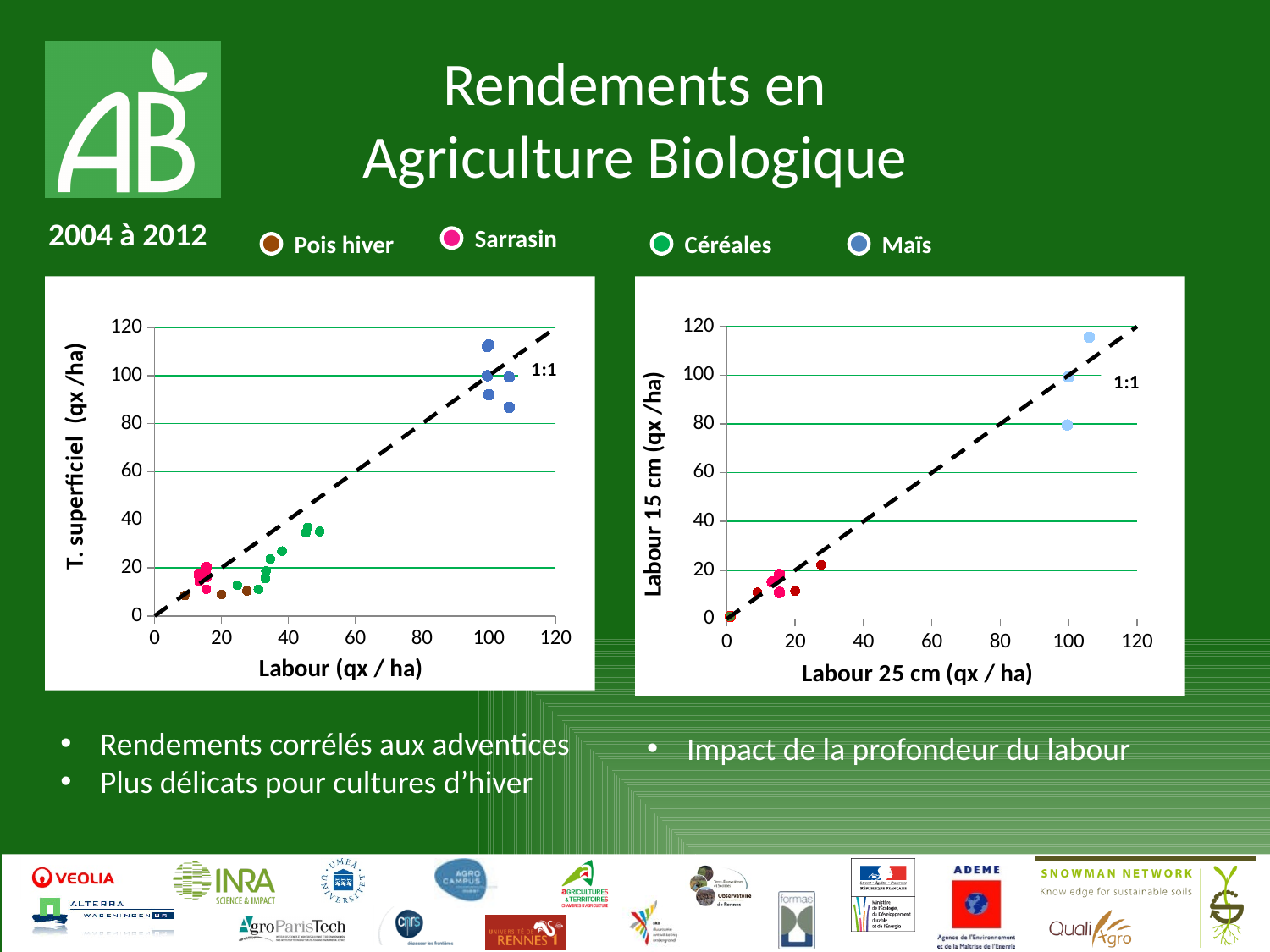
In the right chart, are the Sarrasin points on the x axis (Labour 25 cm) greater or less than 40? less How many series does the legend above the charts list? 4 In the left chart, are the Maïs points on the x axis (Labour) greater or less than 80? greater In the left chart, which series has the highest yield values? Maïs What is the maximum value shown on the x axis of the right chart? 120 In the right chart, which series has the highest yield values? Maïs In the left chart, are the Céréales points on the y axis (T. superficiel) greater or less than 60? less What is the x-axis title of the left chart? Labour (qx / ha) What kind of chart is the right chart on the slide? scatter chart What is the y-axis title of the right chart? Labour 15 cm (qx /ha) What kind of chart is the left chart on the slide? scatter chart